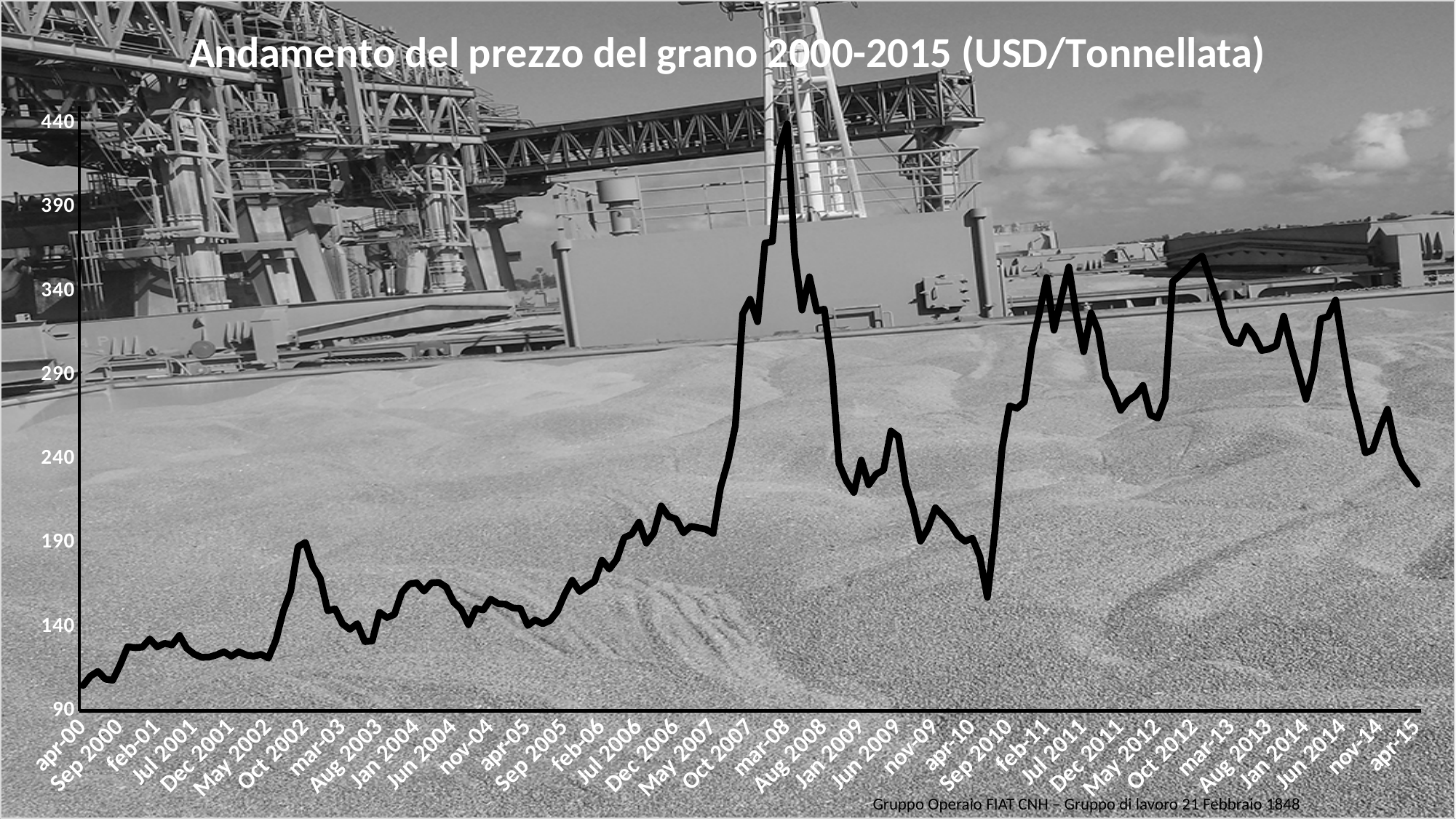
Is the value at Oct 2012 greater or less than 340? greater Which is larger, the value at mar-08 or the value at apr-00? mar-08 What kind of chart is shown on the slide? line chart Is the value at apr-15 greater or less than 240? less What is the title of the chart? Andamento del prezzo del grano 2000-2015 (USD/Tonnellata) Which is larger, the value at Oct 2012 or the value at Jan 2009? Oct 2012 Is the value at Jan 2009 greater or less than 290? less Around which x-axis label does the wheat price reach its highest peak? mar-08 Does the wheat price overall rise or fall from apr-00 to mar-08? rise